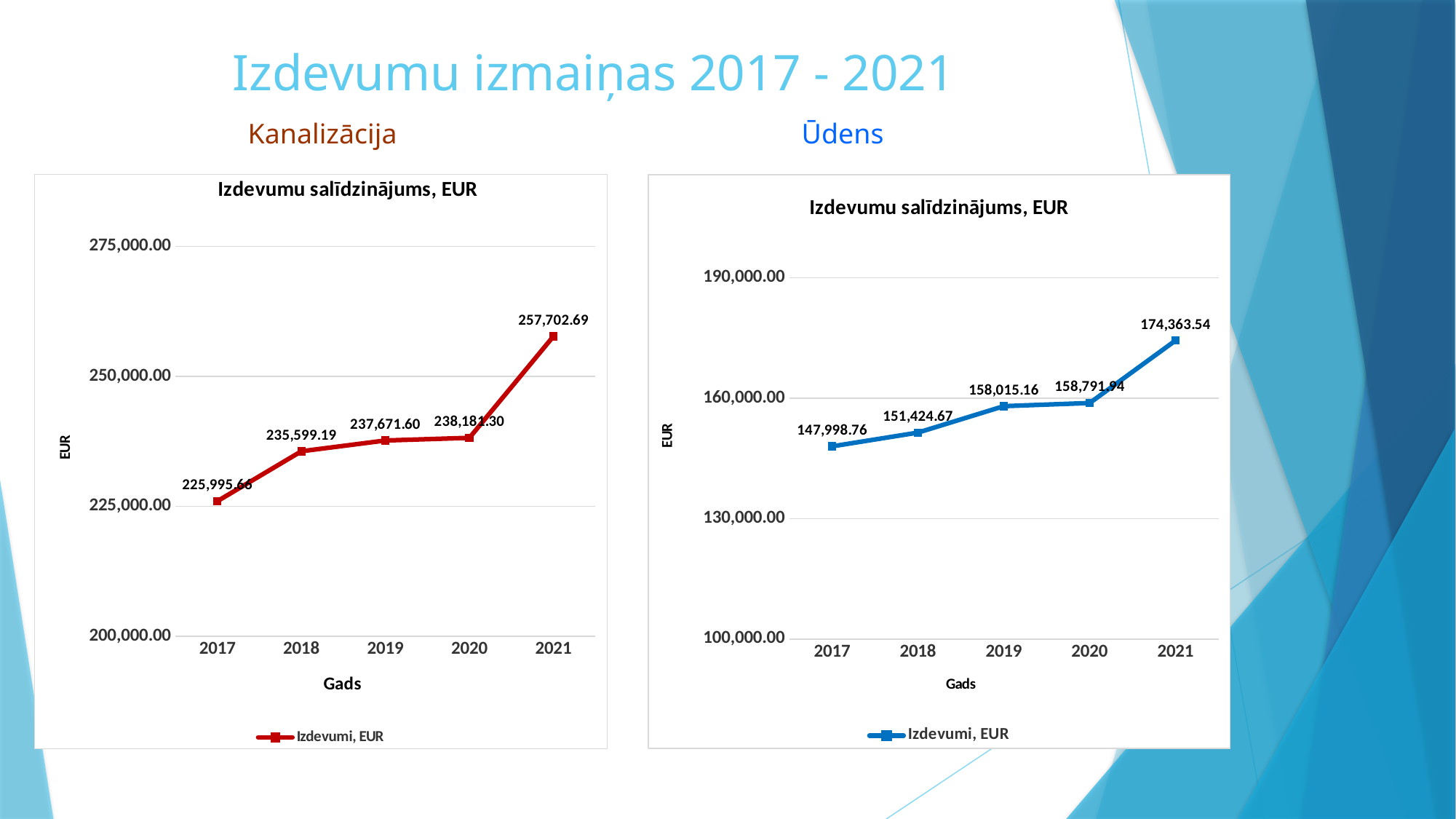
What type of chart is the Kanalizācija chart (left)? Line chart On the Ūdens chart (right), what is the difference between the 2021 and 2017 values? 26,364.78 On the Kanalizācija chart (left), which year has the lowest value? 2017 On the Ūdens chart (right), what is the value for 2019? 158,015.16 How many years are plotted on the Ūdens chart (right)? 5 On the Kanalizācija chart (left), is the value for 2021 greater or less than 250,000.00? greater On the Kanalizācija chart (left), what is the value for 2018? 235,599.19 On the Kanalizācija chart (left), what is the value for 2021? 257,702.69 On the Ūdens chart (right), do the values rise or fall from 2017 to 2021? Rise On the Ūdens chart (right), what is the value for 2017? 147,998.76 On the Kanalizācija chart (left), what is the difference between the 2021 and 2018 values? 22,103.50 On the Ūdens chart (right), which year has the highest value? 2021